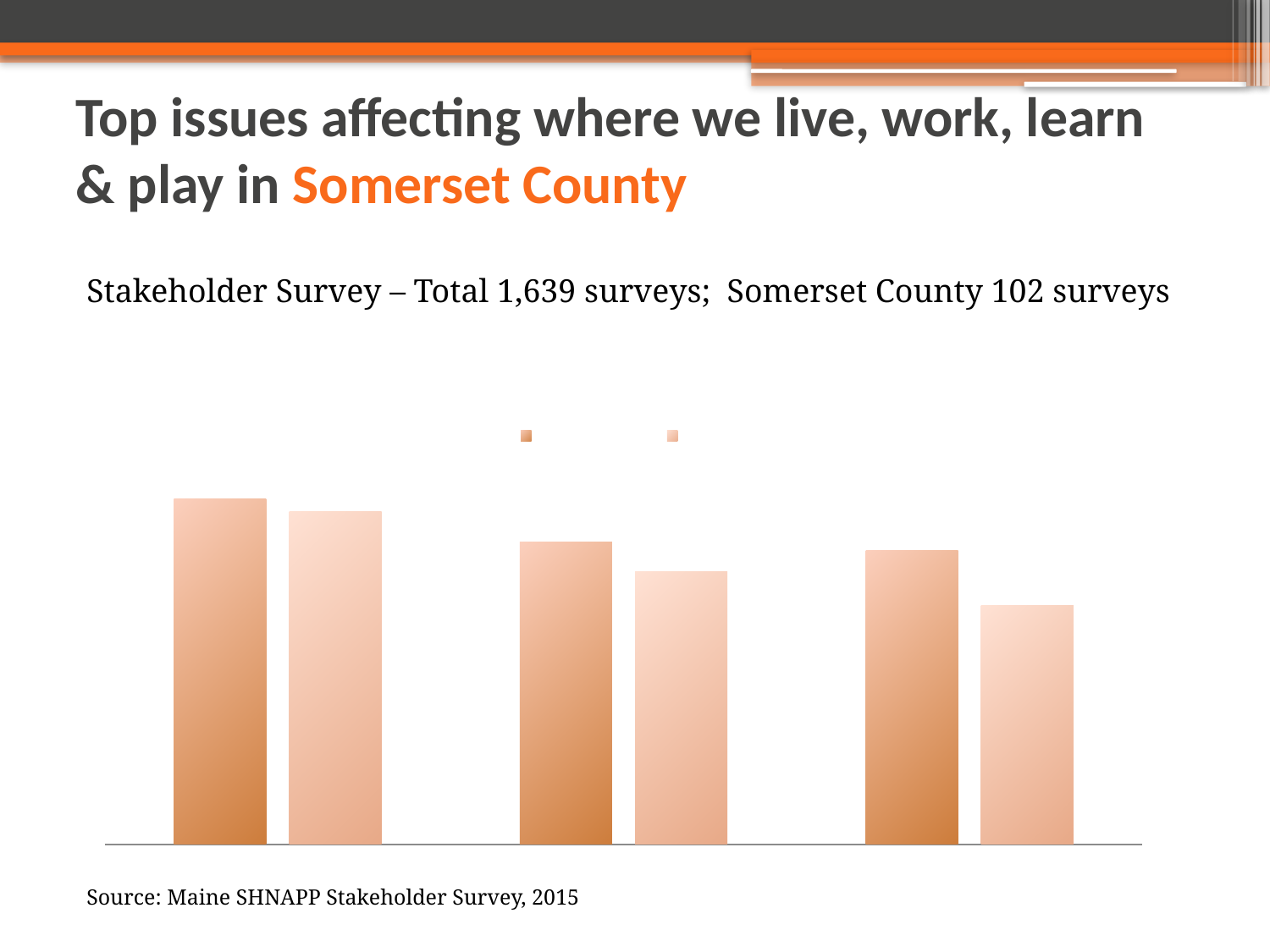
How many bars in total are plotted in the chart? 6 Do the lighter orange bars rise or fall from left to right across the chart? fall In the leftmost group of bars, which bar is taller, the darker orange bar or the lighter orange bar? the darker orange bar How many series does the chart's legend list? 2 In the middle group of bars, which bar is taller, the darker orange bar or the lighter orange bar? the darker orange bar What kind of chart is shown on the slide? bar chart How many groups of bars (categories) are plotted in the chart? 3 Which group of bars has the shortest lighter orange bar: the leftmost, middle, or rightmost? rightmost Which group of bars has the tallest darker orange bar: the leftmost, middle, or rightmost? leftmost What colours are used for the two series in the chart? dark orange and light orange Do the darker orange bars rise or fall from left to right across the chart? fall In the rightmost group of bars, which bar is taller, the darker orange bar or the lighter orange bar? the darker orange bar